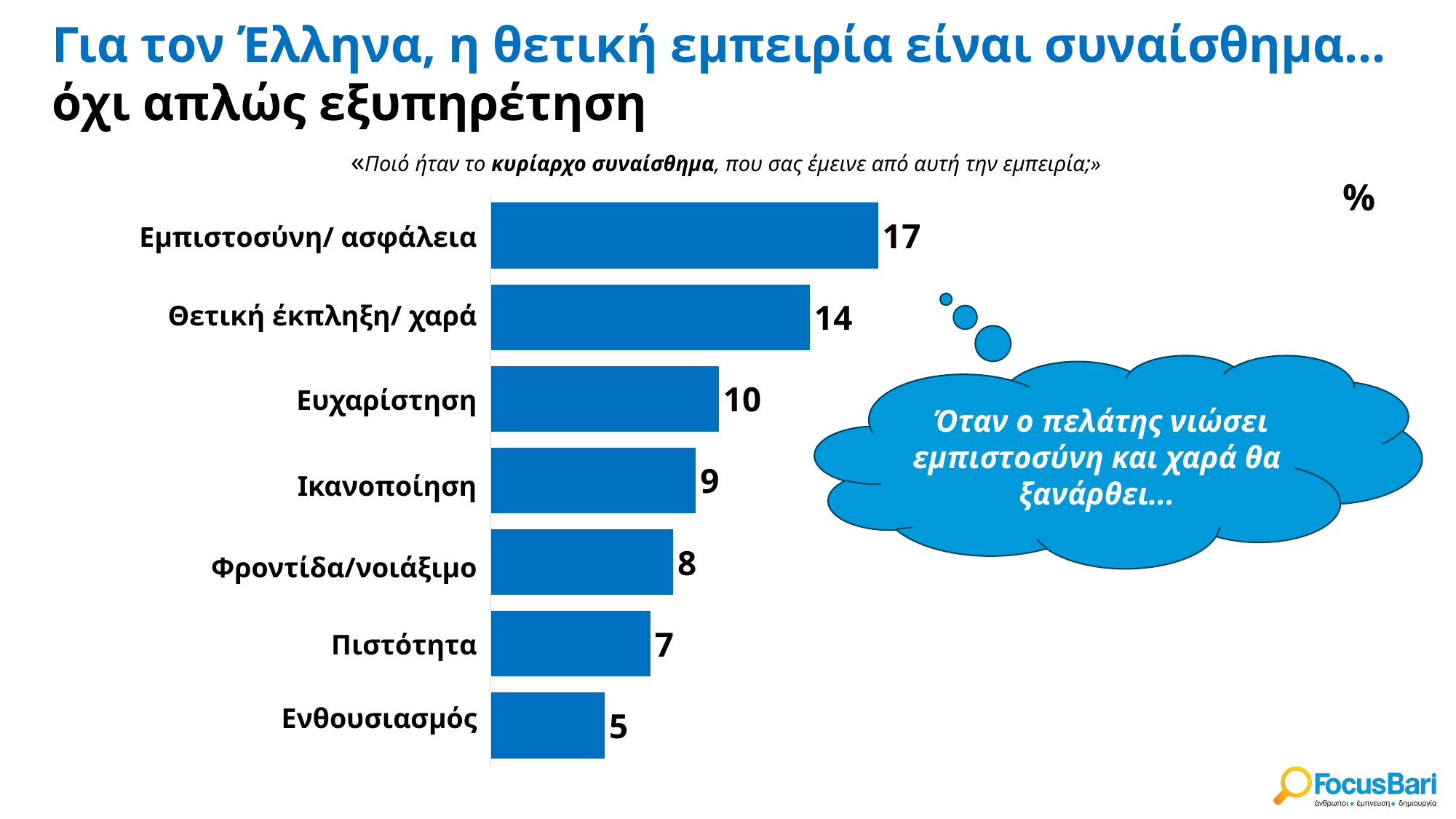
Which is larger, the value for Ικανοποίηση or the value for Πιστότητα? Ικανοποίηση What value is shown for Ενθουσιασμός? 5 Which category has the lowest value? Ενθουσιασμός What value is shown for Εμπιστοσύνη/ ασφάλεια? 17 How many categories are shown in the chart? 7 Which category has the highest value? Εμπιστοσύνη/ ασφάλεια What is the difference between the values for Ευχαρίστηση and Ενθουσιασμός? 5 What value is shown for Φροντίδα/νοιάξιμο? 8 What unit symbol is shown at the top right of the chart? % What is the difference between the values for Εμπιστοσύνη/ ασφάλεια and Θετική έκπληξη/ χαρά? 3 What kind of chart is shown on the slide? Bar chart What value is shown for Θετική έκπληξη/ χαρά? 14